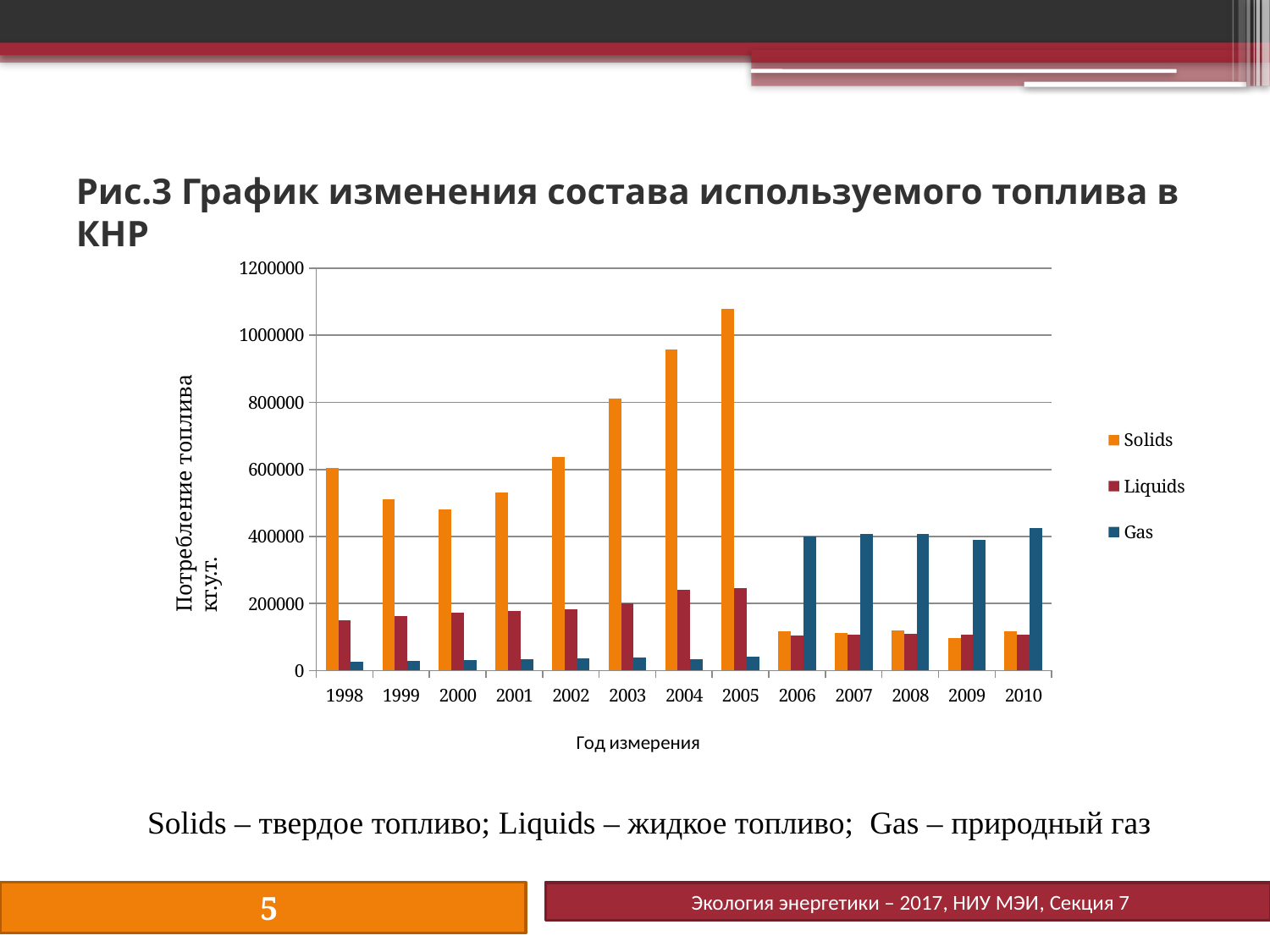
Is the Solids value for 1998 greater or less than 800000? less In 2003, which is larger: Solids or Liquids? Solids Is the Solids value for 2005 greater or less than 1000000? greater In which year is the Solids value highest? 2005 In 2006, which is larger: Gas or Solids? Gas How many series does the legend list? 3 What are the three series listed in the legend? Solids, Liquids, Gas Is the Gas value for 2007 greater or less than 200000? greater In which year is the Gas value highest? 2010 How many years are shown on the x axis? 13 Do the Solids values rise or fall from 2000 to 2005? rise What kind of chart is shown on the slide? bar chart